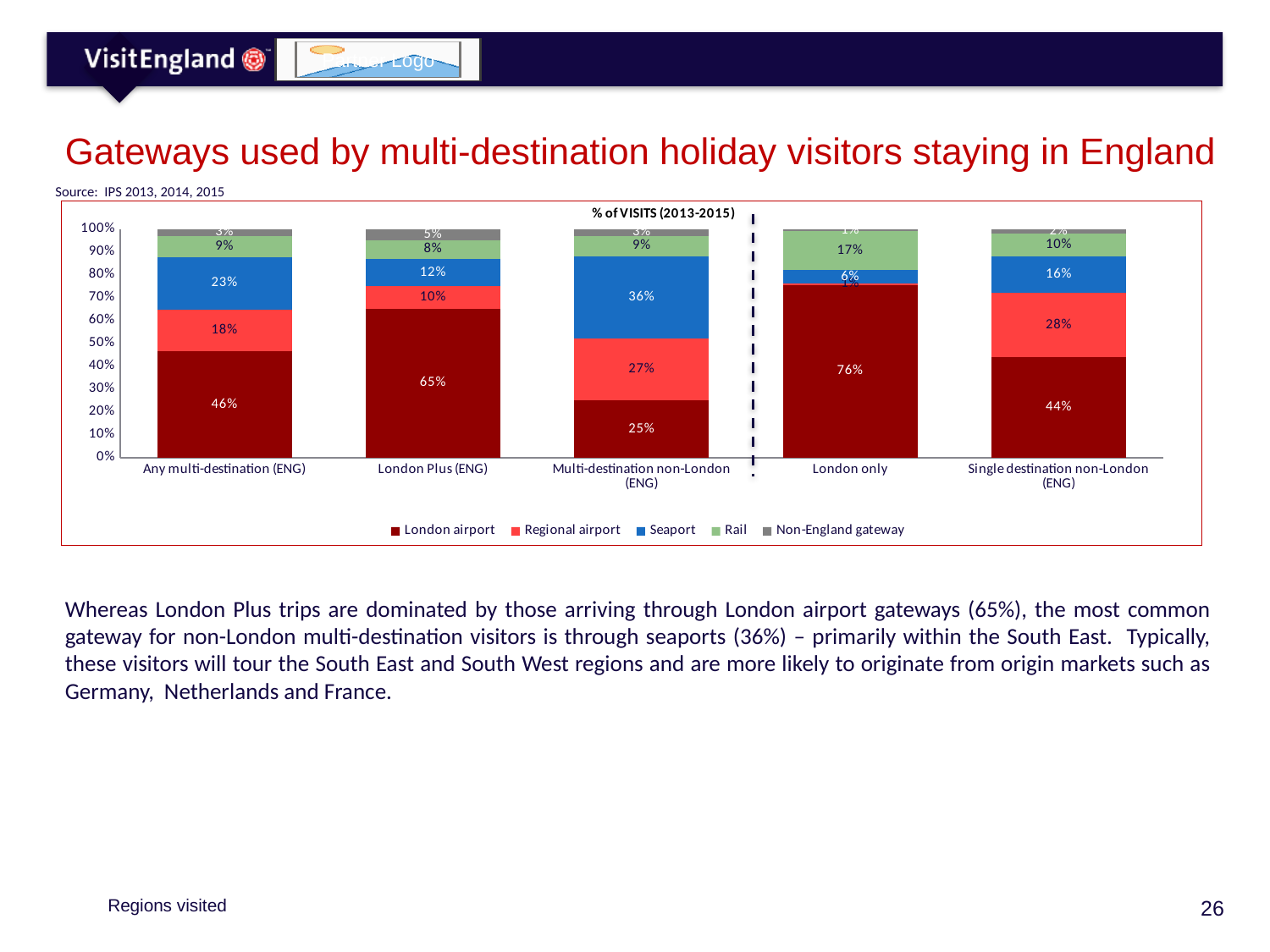
What is the title shown above the chart? % of VISITS (2013-2015) How many series does the legend list? 5 How many categories are shown on the x axis? 5 What is the Regional airport share for Single destination non-London (ENG)? 28% What type of chart is shown on the slide? stacked bar chart What is the Rail share for London only? 17% What is the London airport share for London Plus (ENG)? 65% Which category has the highest London airport share? London only What is the difference between the London airport share for London Plus (ENG) and for Any multi-destination (ENG)? 19% What is the Seaport share for Multi-destination non-London (ENG)? 36% Which is larger: the Seaport share for Any multi-destination (ENG) or for Single destination non-London (ENG)? Any multi-destination (ENG) Which category has the lowest London airport share? Multi-destination non-London (ENG)